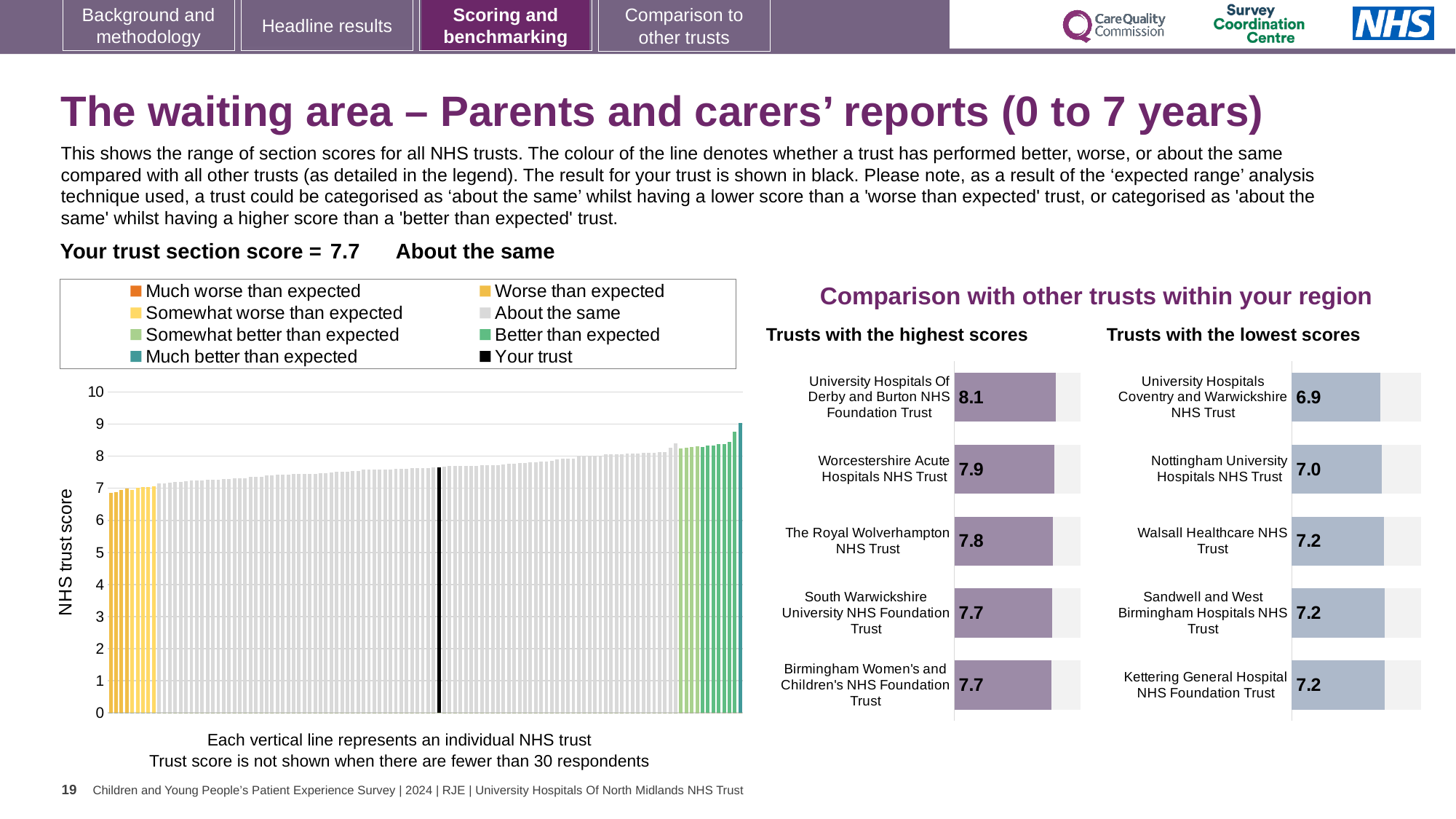
In the 'Trusts with the highest scores' chart, what is the score for University Hospitals Of Derby and Burton NHS Foundation Trust? 8.1 Which has the higher score: The Royal Wolverhampton NHS Trust in the highest scores chart or Nottingham University Hospitals NHS Trust in the lowest scores chart? The Royal Wolverhampton NHS Trust In the 'Trusts with the lowest scores' chart, which trust has the lowest score? University Hospitals Coventry and Warwickshire NHS Trust In the 'Trusts with the highest scores' chart, which trust has the highest score? University Hospitals Of Derby and Burton NHS Foundation Trust How many trusts are shown in the 'Trusts with the highest scores' chart? 5 In the large 'NHS trust score' chart on the left, is the value of the black 'Your trust' bar greater or less than 7? greater What kind of chart is the large 'NHS trust score' chart on the left of the slide? Bar chart In the 'Trusts with the lowest scores' chart, what is the score for Nottingham University Hospitals NHS Trust? 7.0 In the 'Trusts with the highest scores' chart, what is the score for Worcestershire Acute Hospitals NHS Trust? 7.9 In the 'Trusts with the highest scores' chart, what is the difference between the scores of University Hospitals Of Derby and Burton NHS Foundation Trust and The Royal Wolverhampton NHS Trust? 0.3 In the large 'NHS trust score' chart on the left, do the bar values rise or fall from left to right? Rise In the 'Trusts with the lowest scores' chart, what is the score for University Hospitals Coventry and Warwickshire NHS Trust? 6.9